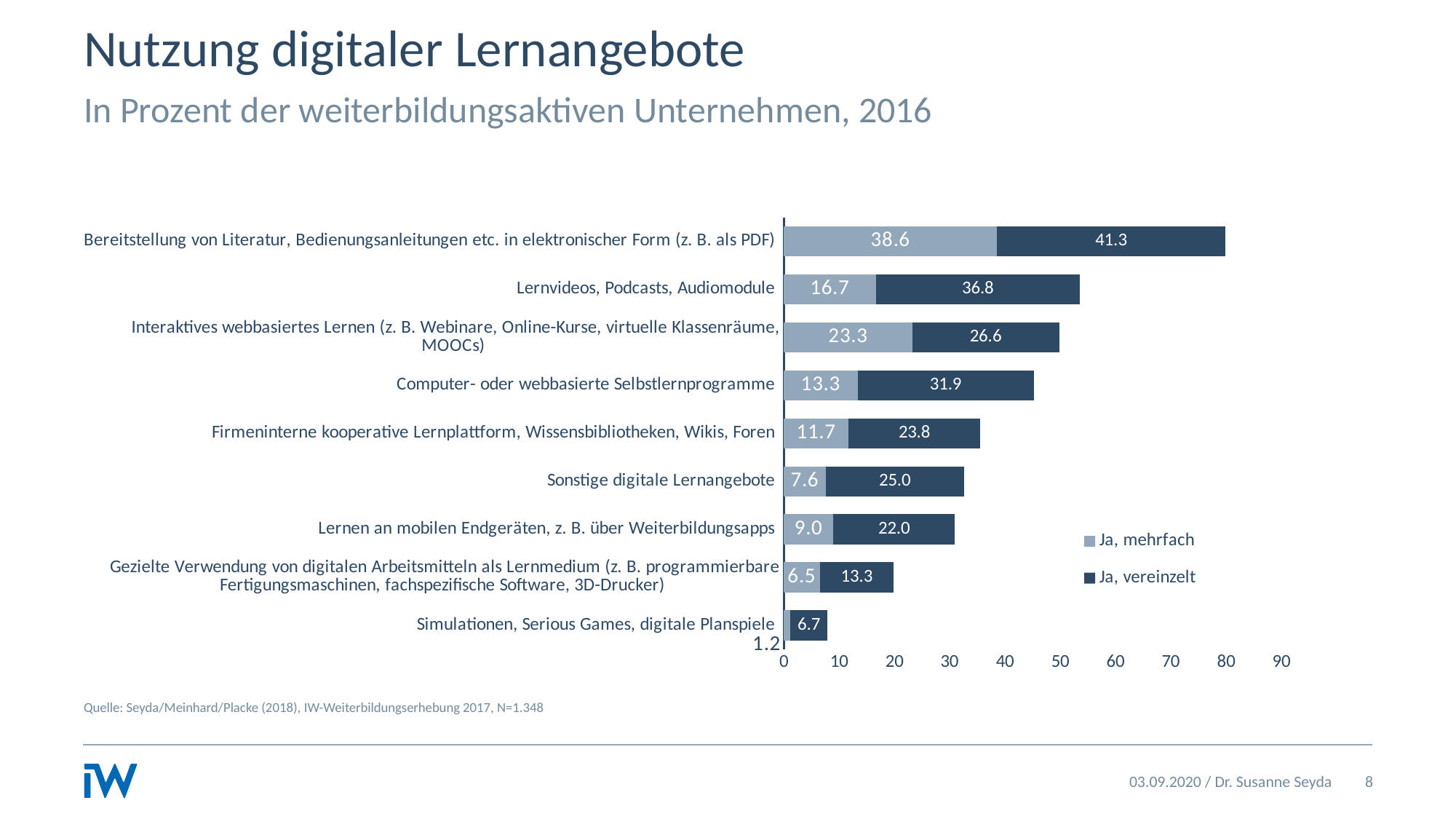
What is the "Ja, mehrfach" value for "Lernvideos, Podcasts, Audiomodule"? 16.7 Which category has the highest "Ja, vereinzelt" value? Bereitstellung von Literatur, Bedienungsanleitungen etc. in elektronischer Form (z. B. als PDF) What is the total of the stacked bar for "Lernen an mobilen Endgeräten, z. B. über Weiterbildungsapps"? 31.0 Which category has the lowest "Ja, mehrfach" value? Simulationen, Serious Games, digitale Planspiele What is the "Ja, mehrfach" value for "Simulationen, Serious Games, digitale Planspiele"? 1.2 How many series does the legend list? 2 What kind of chart is shown on the slide? Stacked bar chart Which is larger for "Sonstige digitale Lernangebote": the "Ja, mehrfach" value or the "Ja, vereinzelt" value? Ja, vereinzelt What is the total of the stacked bar for "Bereitstellung von Literatur, Bedienungsanleitungen etc. in elektronischer Form (z. B. als PDF)"? 79.9 What is the "Ja, vereinzelt" value for "Computer- oder webbasierte Selbstlernprogramme"? 31.9 What is the difference between the "Ja, vereinzelt" and "Ja, mehrfach" values for "Lernvideos, Podcasts, Audiomodule"? 20.1 How many categories are shown in the chart? 9